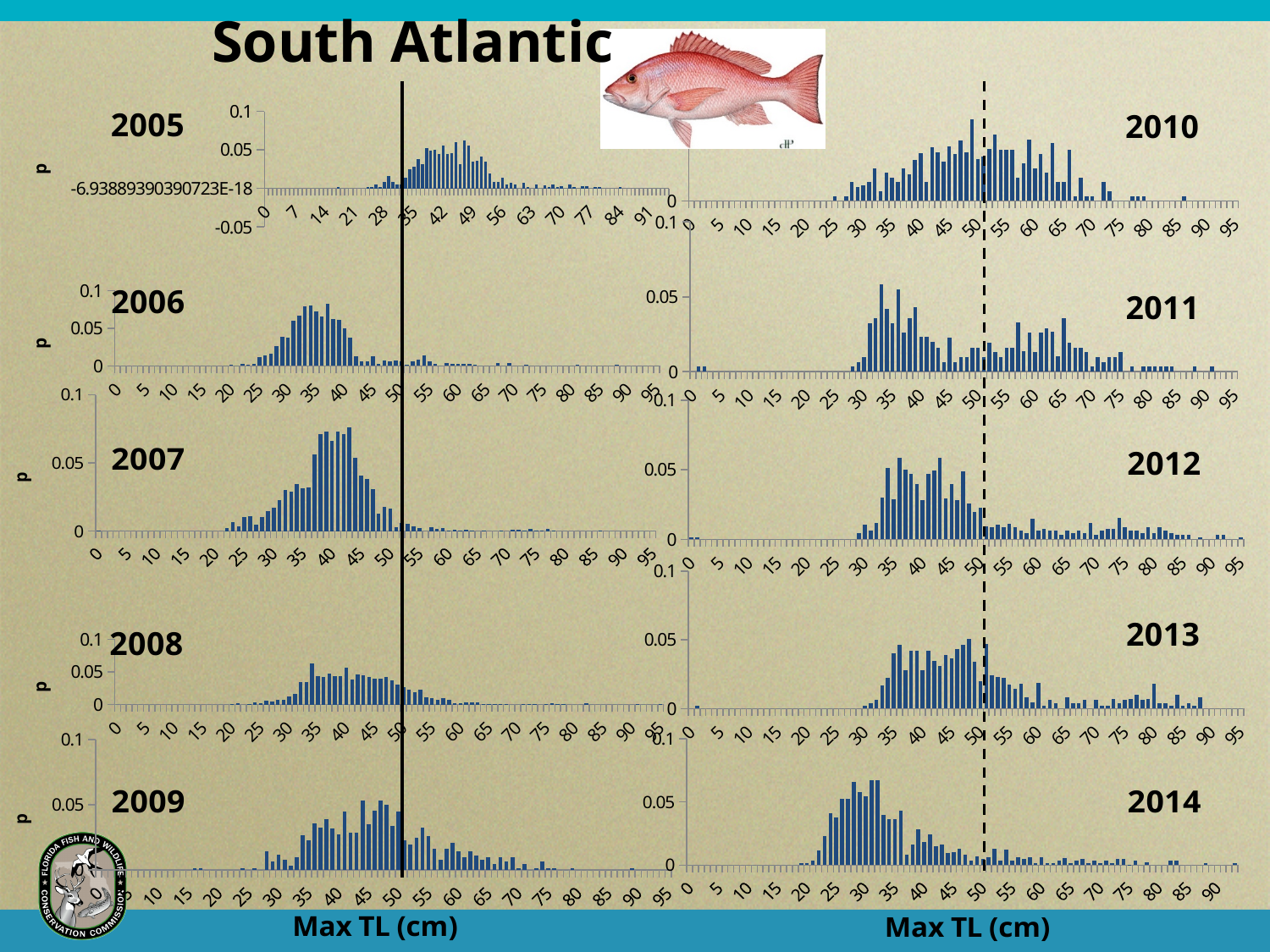
In the 2010 chart, is the value at 5 cm greater or less than 0.05? less In the 2006 chart, is the value at 10 cm greater or less than 0.05? less In the 2012 chart, is the value at 90 cm greater or less than 0.05? less How many yearly charts are shown on the slide? 10 What is the x-axis label shown beneath the charts? Max TL (cm) What kind of chart is used for the 2007 panel on the slide? bar chart